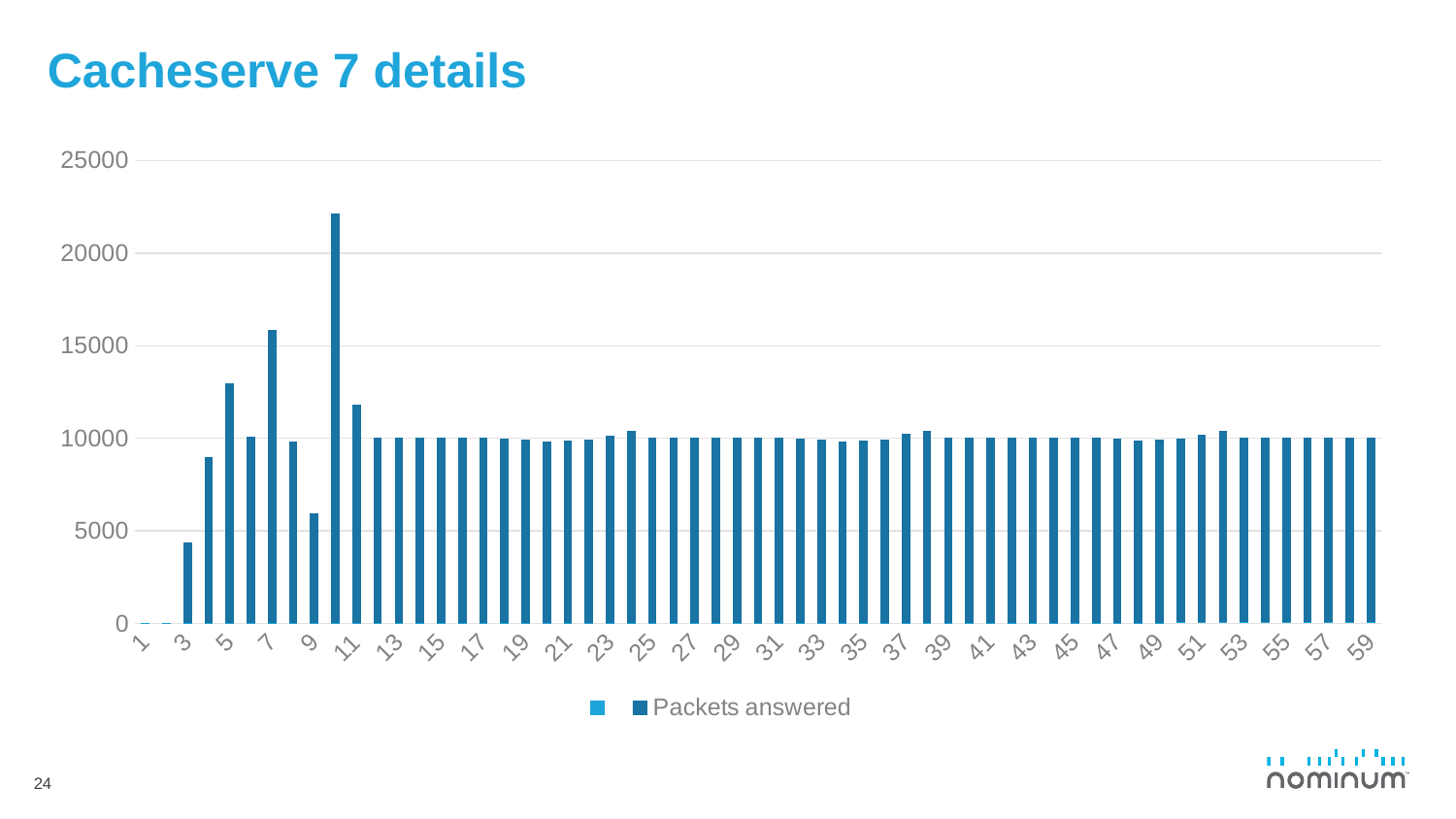
Is the value for x = 5 greater or less than 10000? greater Which has the larger value, x = 3 or x = 9? 9 Is the value for x = 3 greater or less than 5000? less Which x-axis position has the tallest bar? 10 Is the value of the tallest bar greater or less than 20000? greater What is the last x-axis label shown on the chart? 59 Which has the larger value, x = 5 or x = 7? 7 What kind of chart is shown on the slide? bar chart What is the name of the labelled series in the legend? Packets answered How many series does the legend list? 2 What is the title of the slide's chart? Cacheserve 7 details